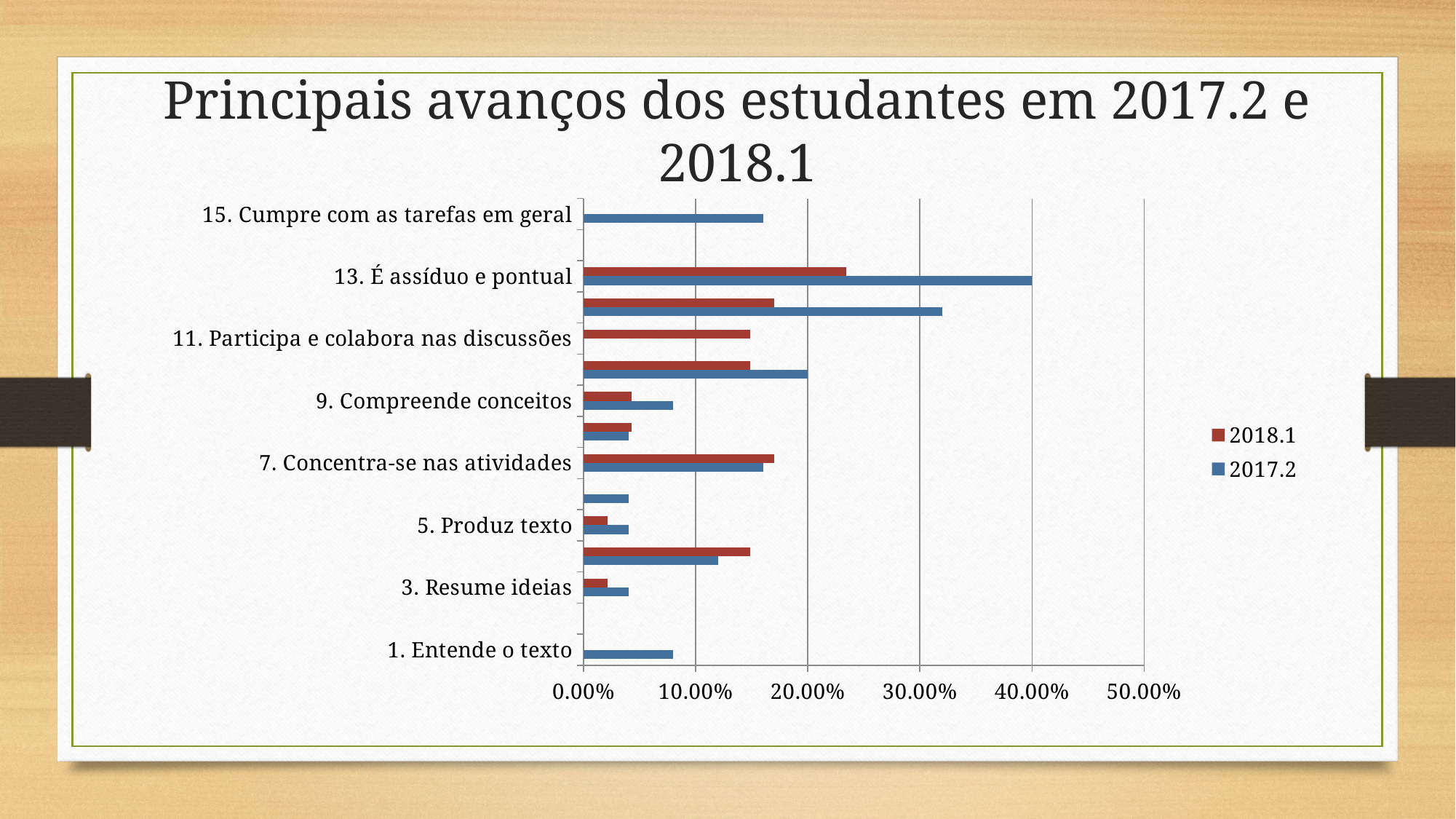
Is the 2017.2 value for '13. É assíduo e pontual' greater or less than 30.00%? greater What are the two series named in the legend? 2018.1 and 2017.2 Is the 2017.2 value for '15. Cumpre com as tarefas em geral' greater or less than 10.00%? greater Which category has the highest value for the 2018.1 series? 13. É assíduo e pontual Is the 2017.2 value for '9. Compreende conceitos' greater or less than 10.00%? less How many series does the legend list? 2 Which colour represents the 2017.2 series? Blue Which category has the highest value for the 2017.2 series? 13. É assíduo e pontual For '5. Produz texto', which series has the larger value, 2017.2 or 2018.1? 2017.2 For '13. É assíduo e pontual', which series has the larger value, 2017.2 or 2018.1? 2017.2 What kind of chart is shown on the slide? Bar chart